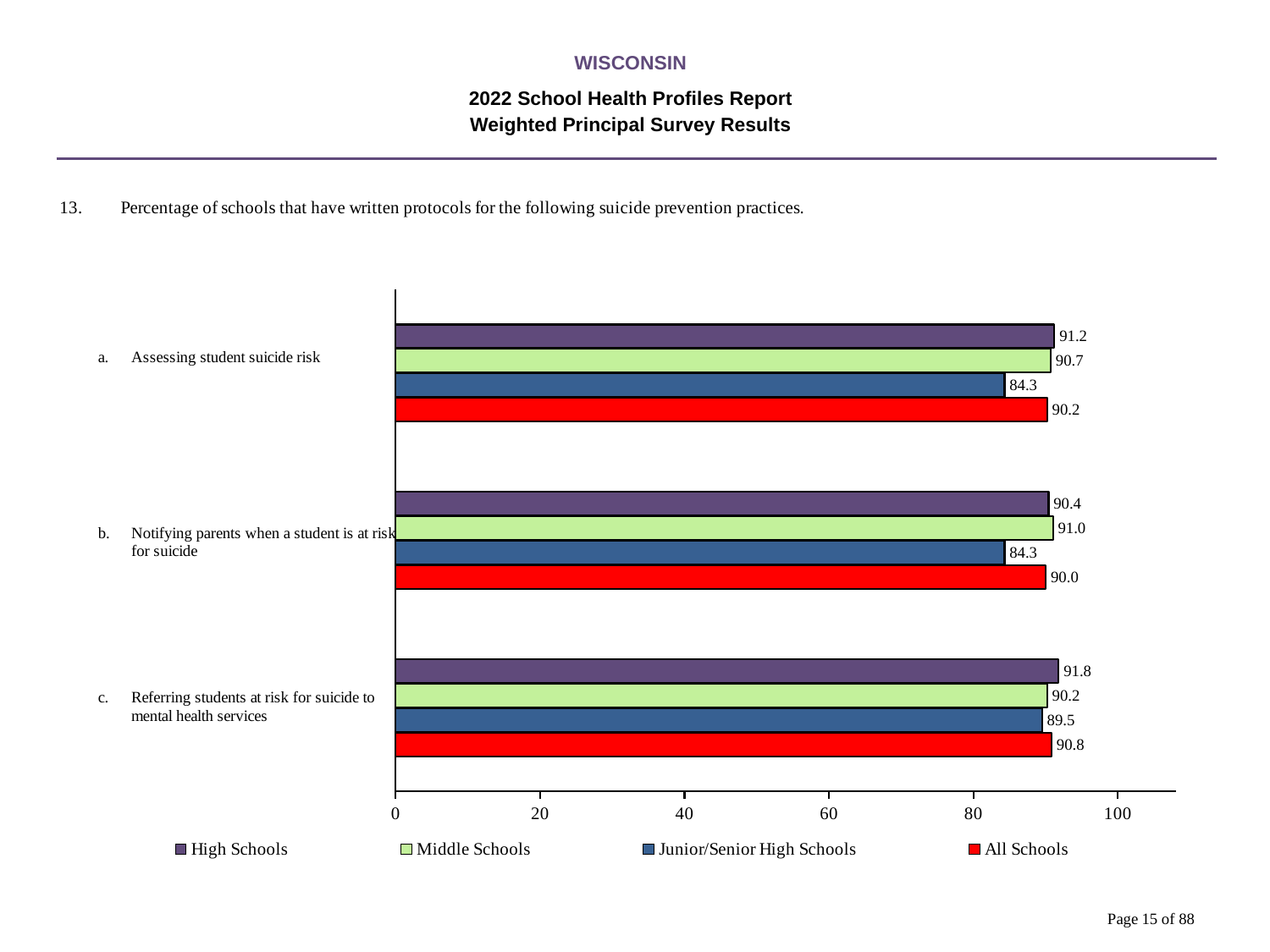
Which series has the lowest value for 'Assessing student suicide risk'? Junior/Senior High Schools Which is larger for 'Referring students at risk for suicide to mental health services': the Middle Schools value or the Junior/Senior High Schools value? Middle Schools What kind of chart is shown on the slide? Bar chart What is the value for All Schools for 'Referring students at risk for suicide to mental health services'? 90.8 Is the value for Junior/Senior High Schools for 'Notifying parents when a student is at risk for suicide' greater or less than 80? greater How many series does the legend list? 4 How many suicide prevention practices (categories) are shown on the chart? 3 What is the difference between the High Schools and Junior/Senior High Schools values for 'Assessing student suicide risk'? 6.9 Which series has the highest value for 'Referring students at risk for suicide to mental health services'? High Schools What is the value for Middle Schools for 'Notifying parents when a student is at risk for suicide'? 91.0 What is the value for High Schools for 'Assessing student suicide risk'? 91.2 What is the value for Junior/Senior High Schools for 'Notifying parents when a student is at risk for suicide'? 84.3